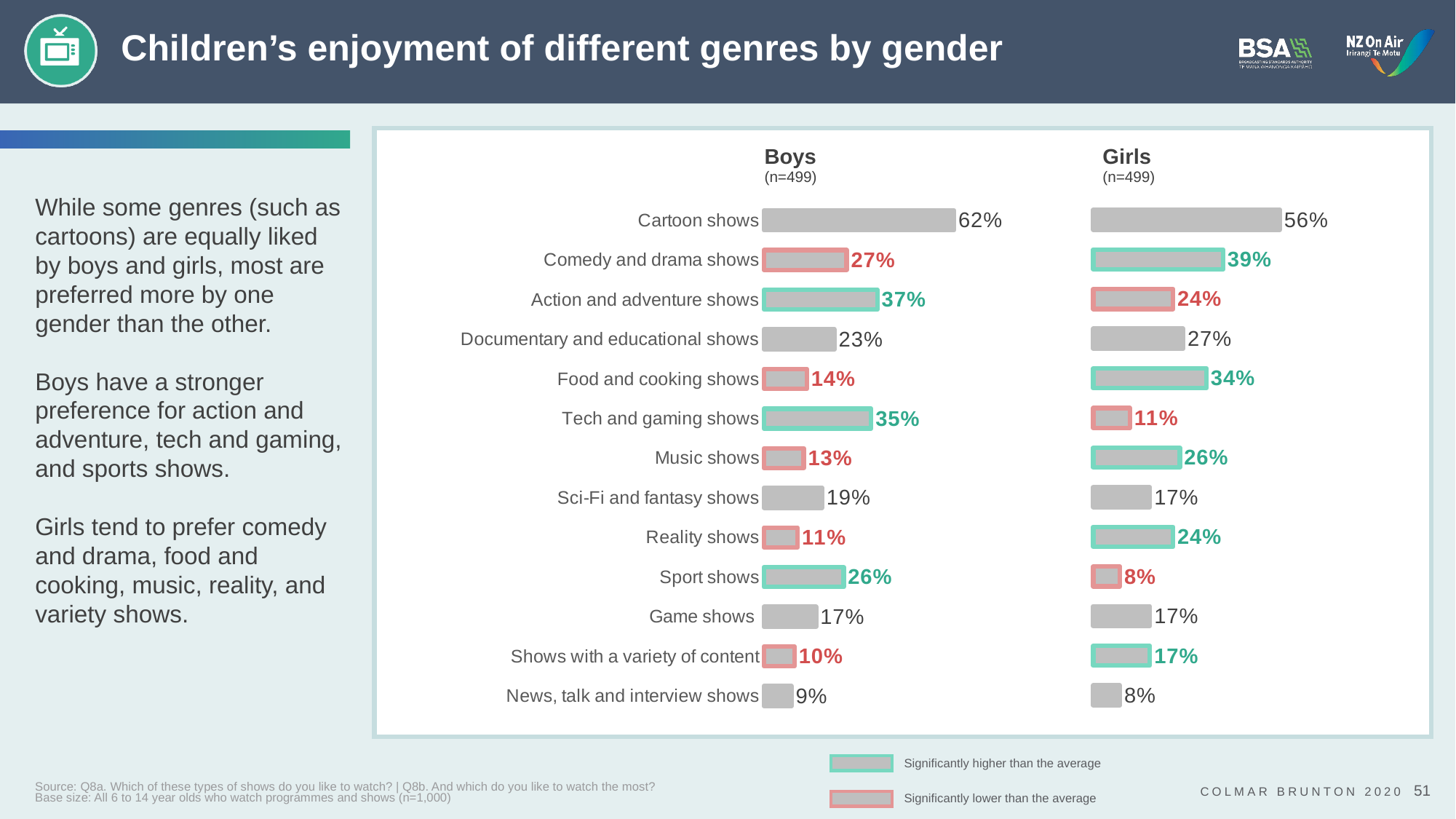
Which is larger for action and adventure shows, the boys' value or the girls' value? Boys According to the legend, what does a green outline on a bar indicate? Significantly higher than the average How many genres are listed in the chart? 13 Which is larger for reality shows, the boys' value or the girls' value? Girls What is the difference between the girls' and boys' values for comedy and drama shows? 12% What type of chart is shown on the slide? Bar chart What percentage of girls enjoy food and cooking shows? 34% What is the difference between the boys' and girls' values for sport shows? 18% What percentage of boys enjoy cartoon shows? 62% Which genre has the lowest value for boys? News, talk and interview shows Which genre has the highest value for girls? Cartoon shows What percentage of girls enjoy tech and gaming shows? 11%